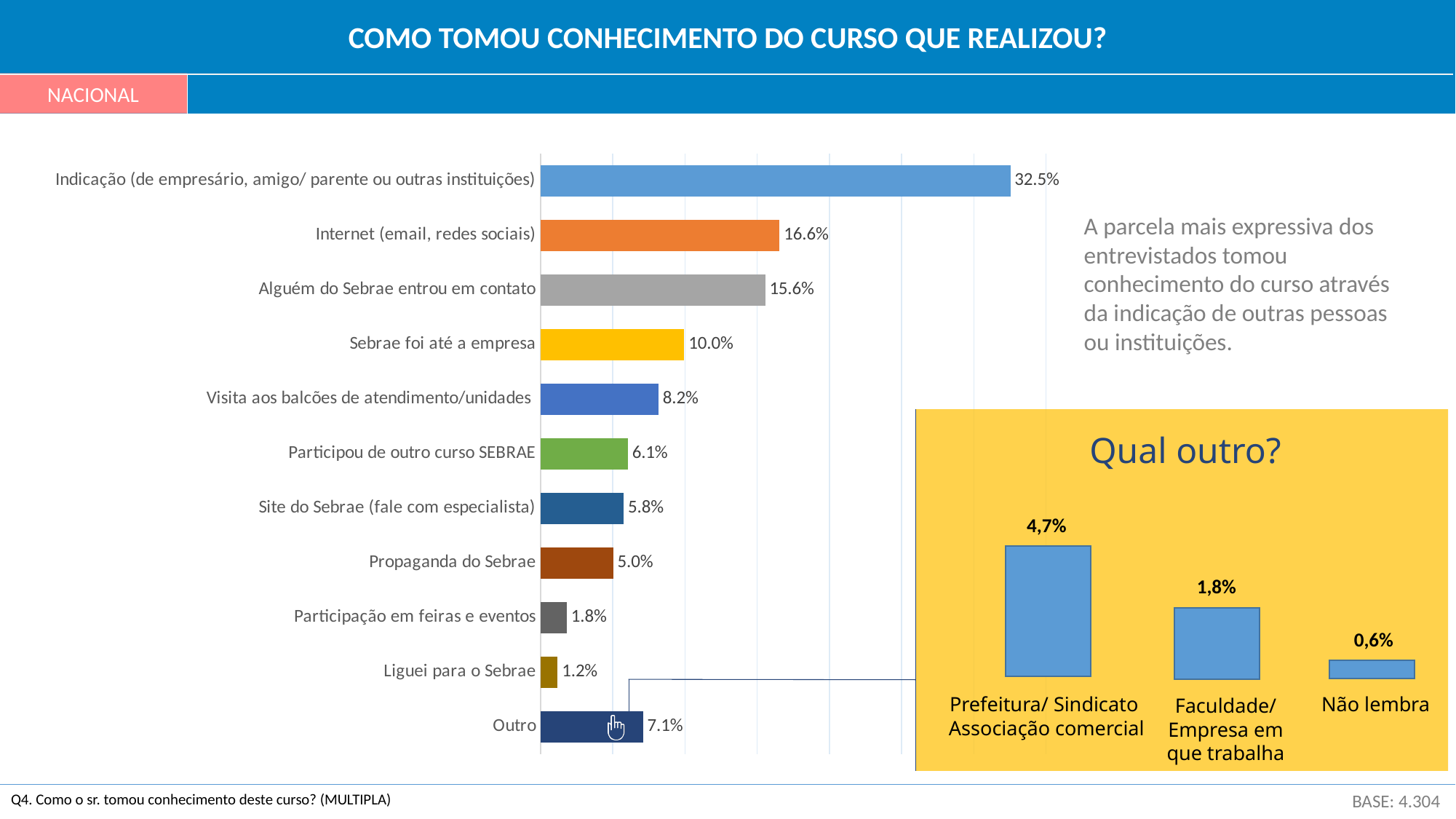
In the 'Qual outro?' chart, what is the value for 'Prefeitura/ Sindicato Associação comercial'? 4,7% In the main chart, what is the value for 'Sebrae foi até a empresa'? 10.0% In the main chart, which category has the lowest value? Liguei para o Sebrae In the main chart, what is the value for 'Outro'? 7.1% In the main chart, which category has the highest value? Indicação (de empresário, amigo/ parente ou outras instituições) In the 'Qual outro?' chart, which category has the lowest value? Não lembra How many categories does the main chart show? 11 What kind of chart is the main chart? Bar chart In the main chart, what is the difference between 'Internet (email, redes sociais)' and 'Alguém do Sebrae entrou em contato'? 1.0% In the main chart, what is the value for 'Internet (email, redes sociais)'? 16.6% How many categories does the 'Qual outro?' chart show? 3 In the main chart, which is larger: 'Visita aos balcões de atendimento/unidades' or 'Participou de outro curso SEBRAE'? Visita aos balcões de atendimento/unidades